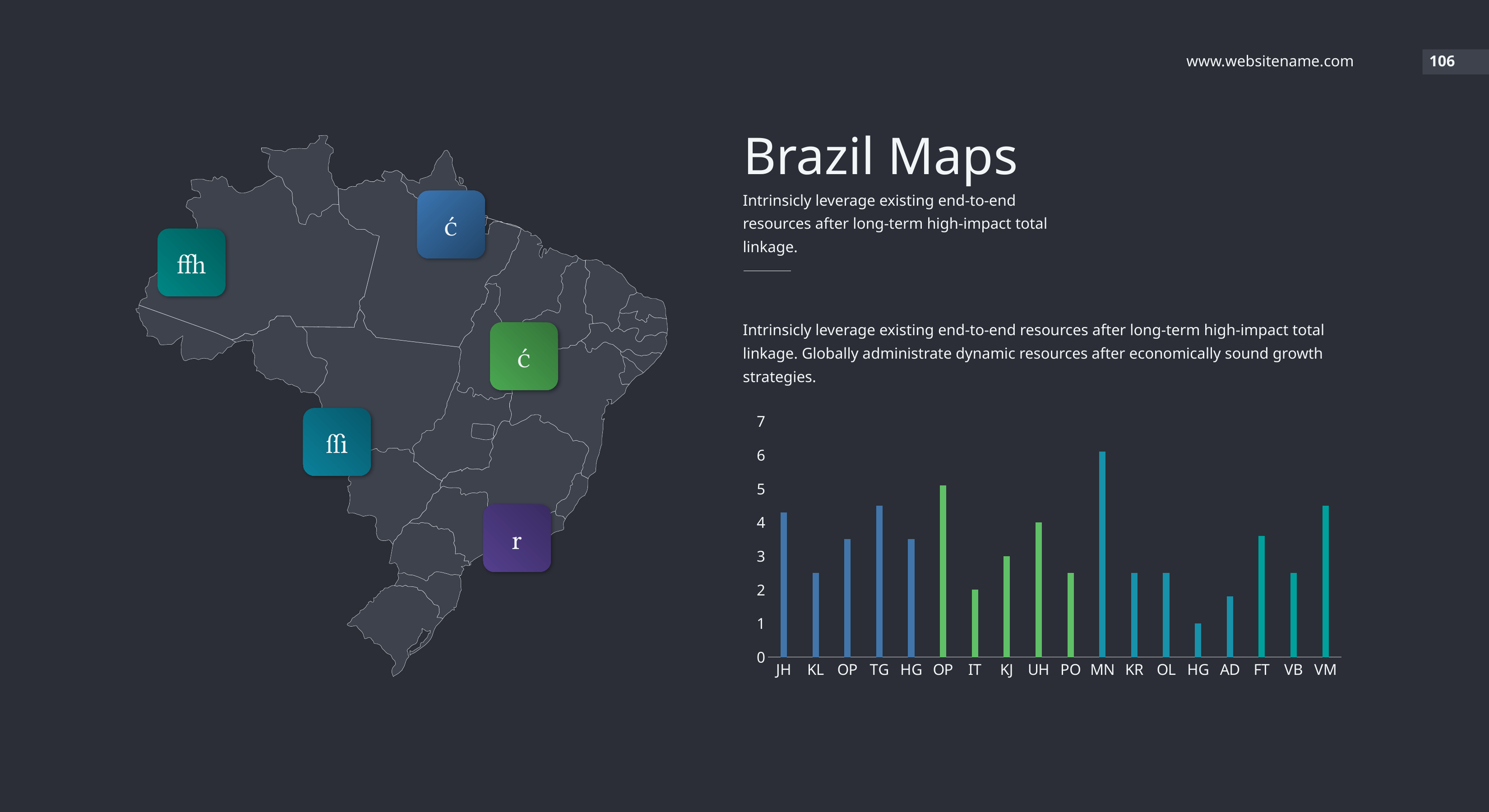
Is the value for AD greater or less than 3? less Is the value for VM greater or less than 4? greater Is the value for IT greater or less than 3? less Which is larger, the value for MN or the value for VM? MN What is the highest value shown on the chart's vertical axis? 7 How many categories are shown on the x axis of the bar chart? 18 Which is larger, the value for KJ or the value for IT? KJ Which category has the highest bar in the chart? MN What kind of chart is shown on the slide? bar chart